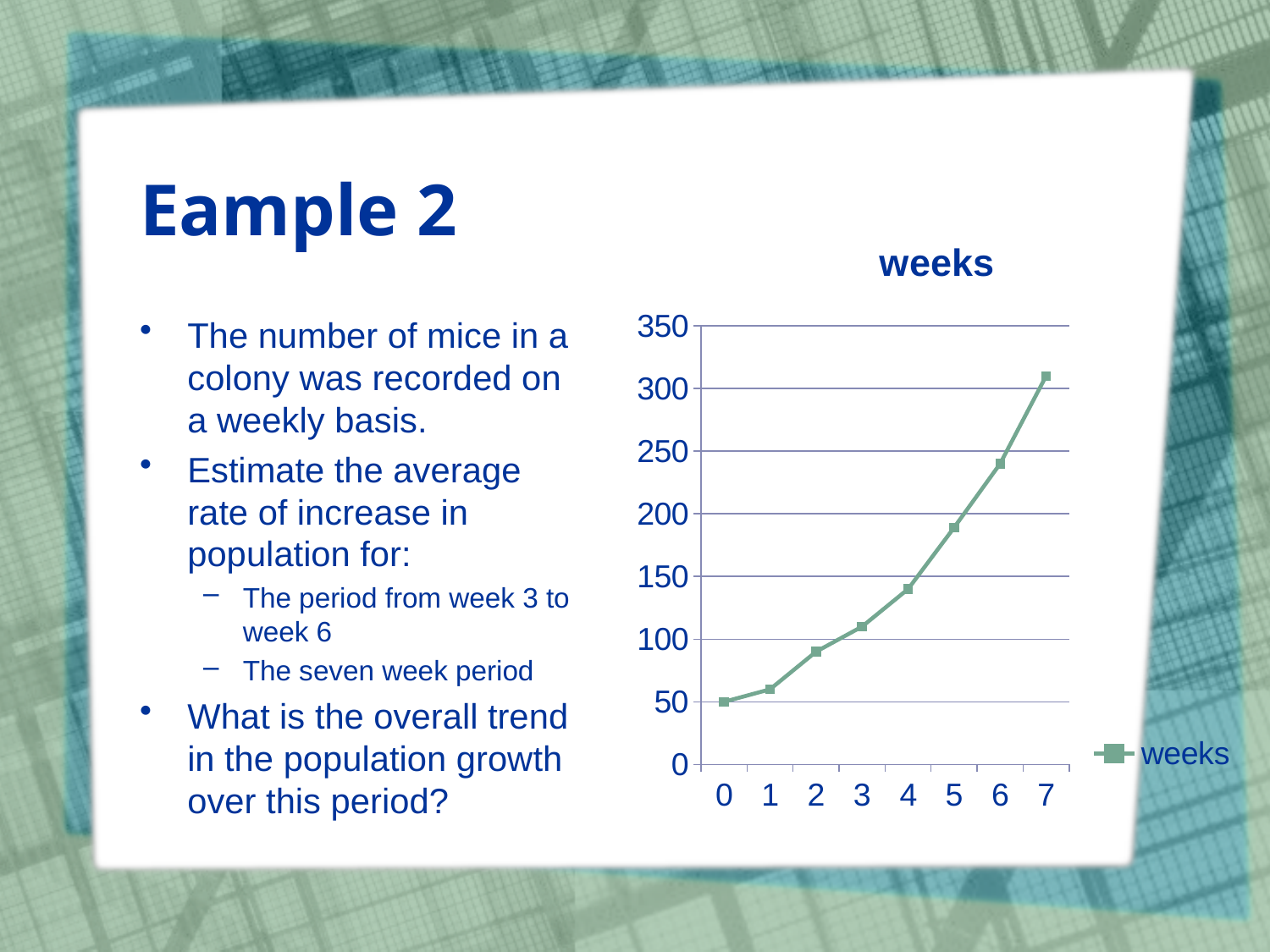
Is the value for week 3 greater or less than 100? greater How many data points are plotted on the line? 8 At which week is the plotted value highest? 7 Do the values rise or fall as the weeks increase along the x axis? rise What is the title of the chart? weeks What is the value plotted at week 0? 50 At which week is the plotted value lowest? 0 What kind of chart is shown on the slide? line chart Which is larger, the value at week 6 or the value at week 3? week 6 How many series does the legend list? 1 Is the value for week 7 greater or less than 300? greater Is the value for week 5 greater or less than 200? less